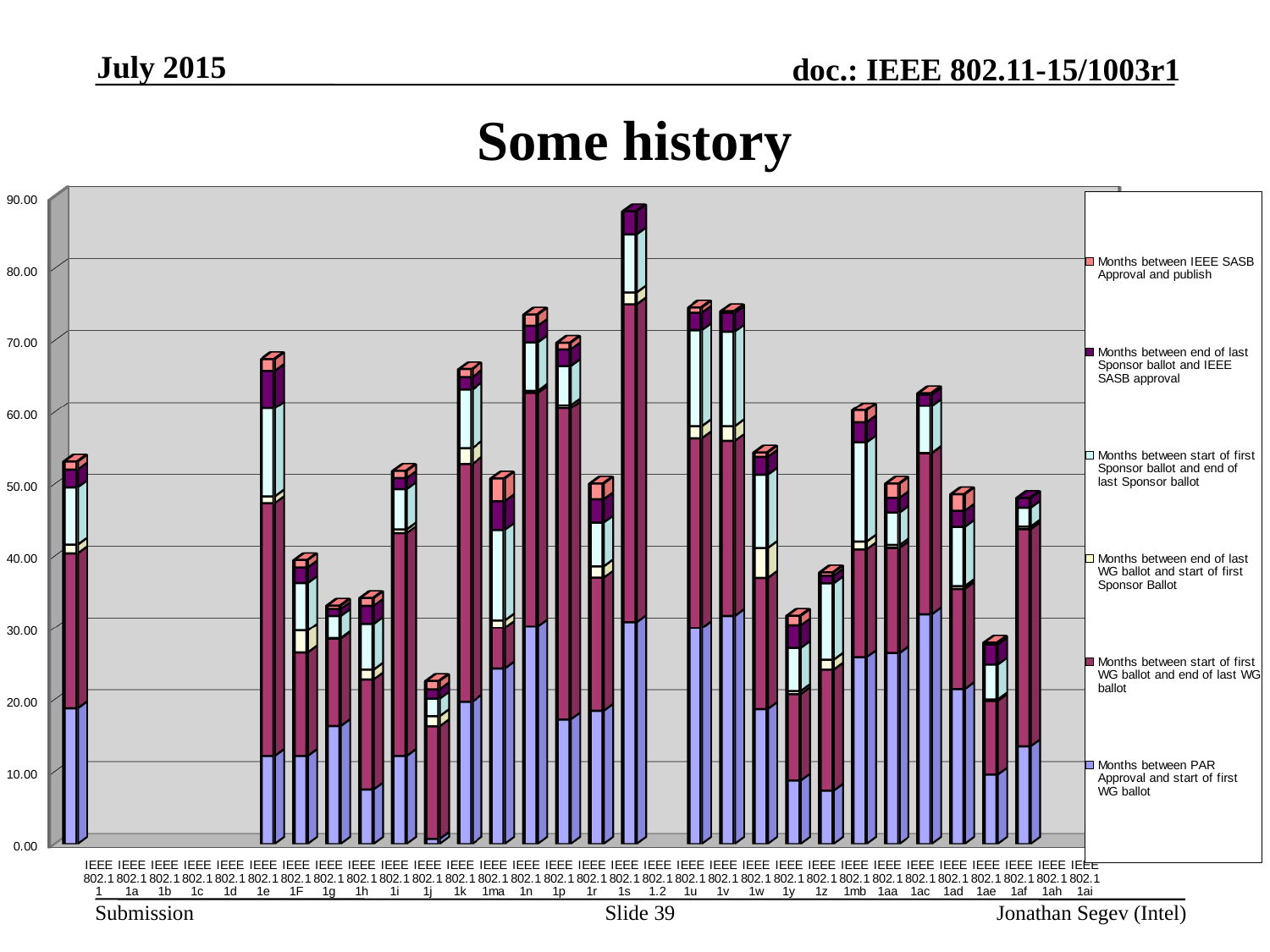
Which category has the tallest stacked bar? IEEE 802.11s Is the total stacked bar for IEEE 802.11j greater or less than 30? less How many categories are labelled along the x axis? 31 Among the bars shown, which category has the shortest stacked bar? IEEE 802.11j Which series is listed last (at the bottom) in the legend? Months between PAR Approval and start of first WG ballot Which has the taller stacked bar, IEEE 802.11s or IEEE 802.11e? IEEE 802.11s How many series does the legend list? 6 What kind of chart is shown on the slide? Stacked bar chart Is the total stacked bar for IEEE 802.11e greater or less than 60? greater Which has the taller stacked bar, IEEE 802.11j or IEEE 802.11k? IEEE 802.11k Is the total stacked bar for IEEE 802.11s greater or less than 80? greater What is the title of the chart? Some history